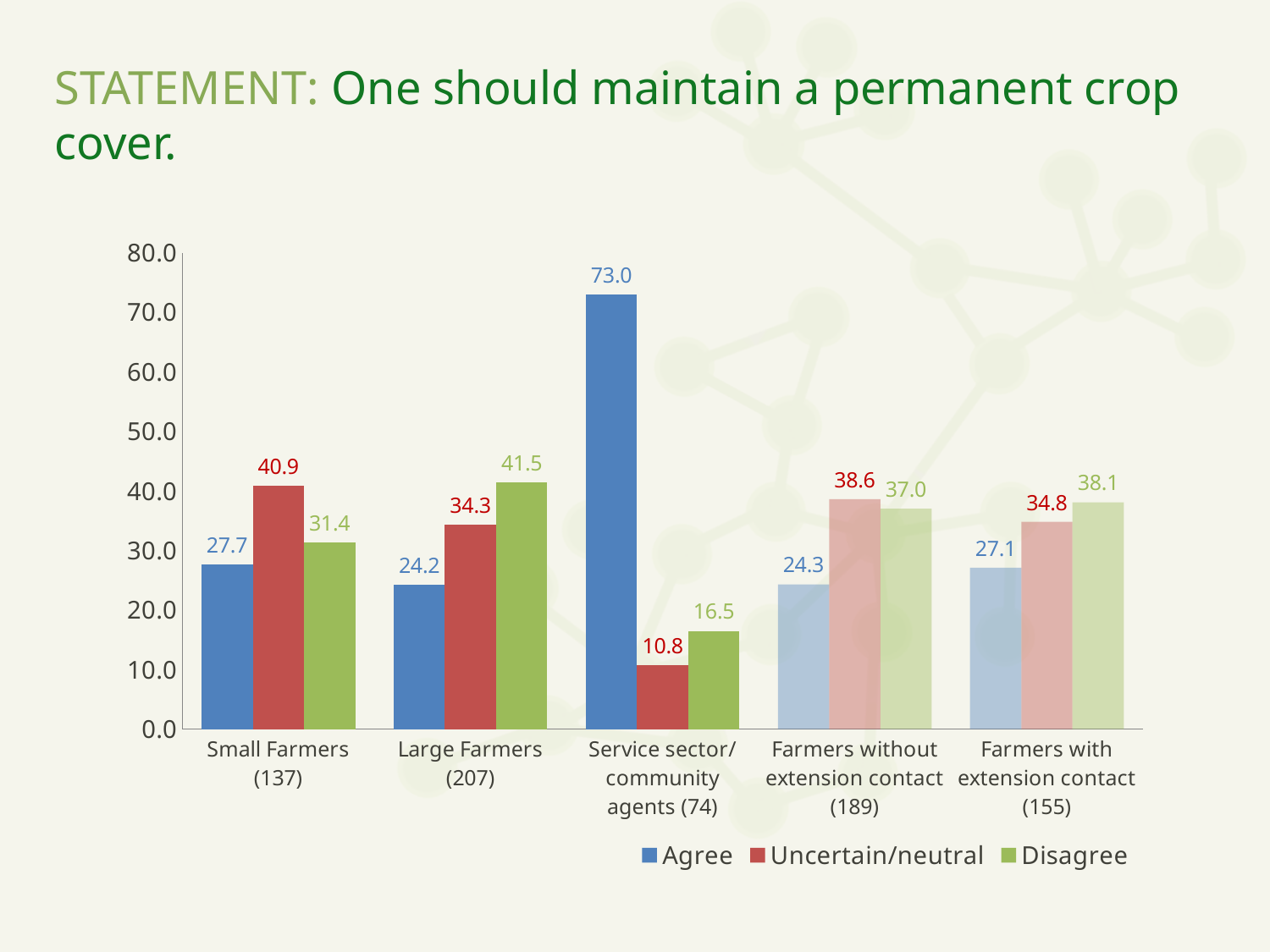
What is the difference between the Disagree values for Large Farmers (207) and Small Farmers (137)? 10.1 Which is larger: the Agree value for Farmers with extension contact (155) or for Farmers without extension contact (189)? Farmers with extension contact (155) What is the Agree value for Service sector/community agents (74)? 73.0 Is the Agree value for Service sector/community agents (74) greater or less than 70.0? greater Which series is shown in red in the legend? Uncertain/neutral Which category has the highest Agree value? Service sector/community agents (74) What kind of chart is shown on the slide? Bar chart What is the Disagree value for Large Farmers (207)? 41.5 How many series does the legend list? 3 Which category has the lowest Uncertain/neutral value? Service sector/community agents (74) How many categories are shown on the x axis? 5 What is the Uncertain/neutral value for Small Farmers (137)? 40.9